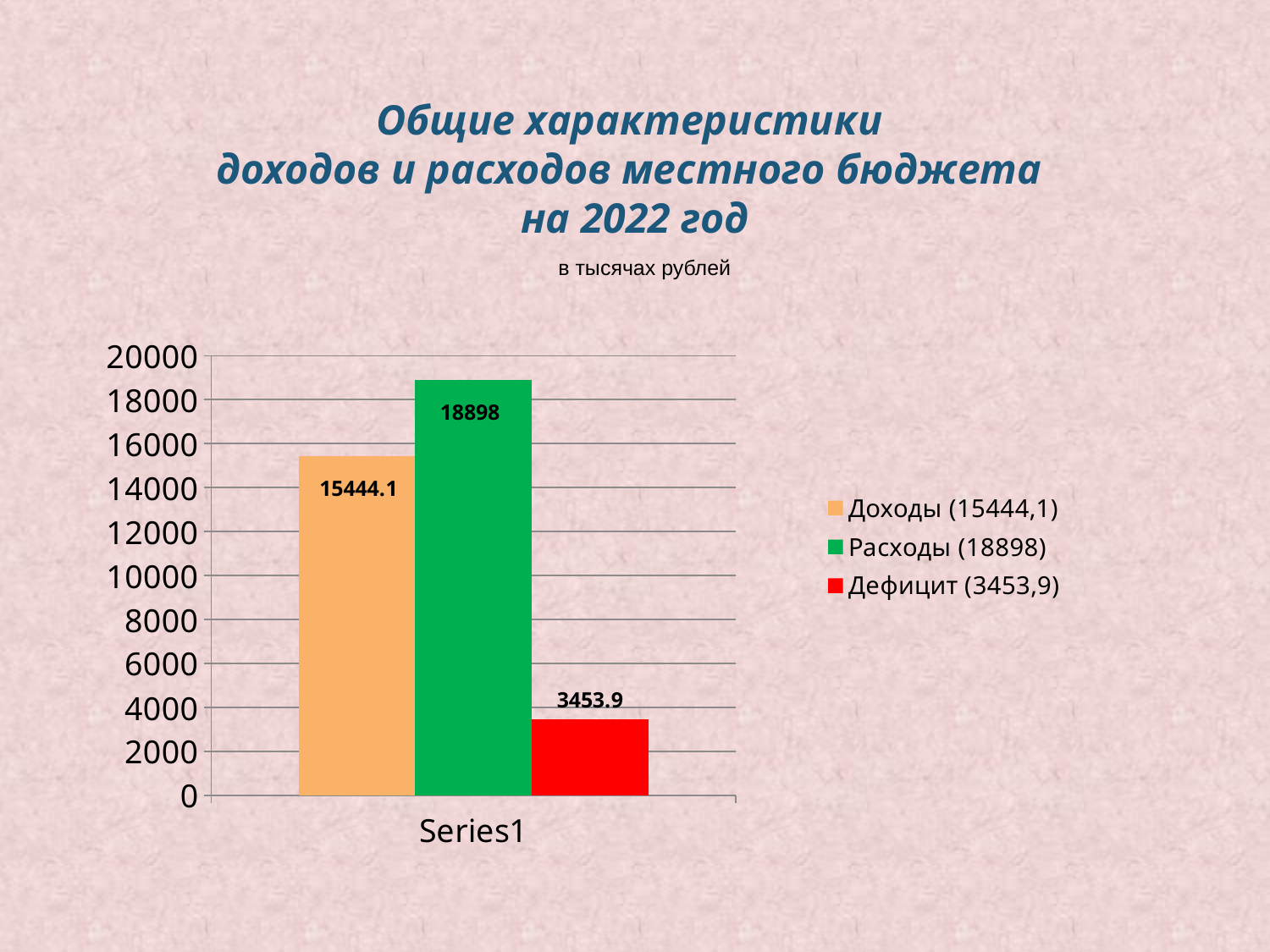
What kind of chart is shown on the slide? bar chart What is the value of the Доходы bar? 15444.1 What is the difference between the Расходы and Доходы values? 3453.9 What colour is the Расходы bar? green What is the value of the Дефицит bar? 3453.9 How many series does the legend list? 3 Which series has the lowest value? Дефицит What is the value of the Расходы bar? 18898 Which series has the highest value? Расходы What unit is stated below the chart title? в тысячах рублей Which is larger, Доходы or Расходы? Расходы Is the value for Доходы greater or less than 16000? less